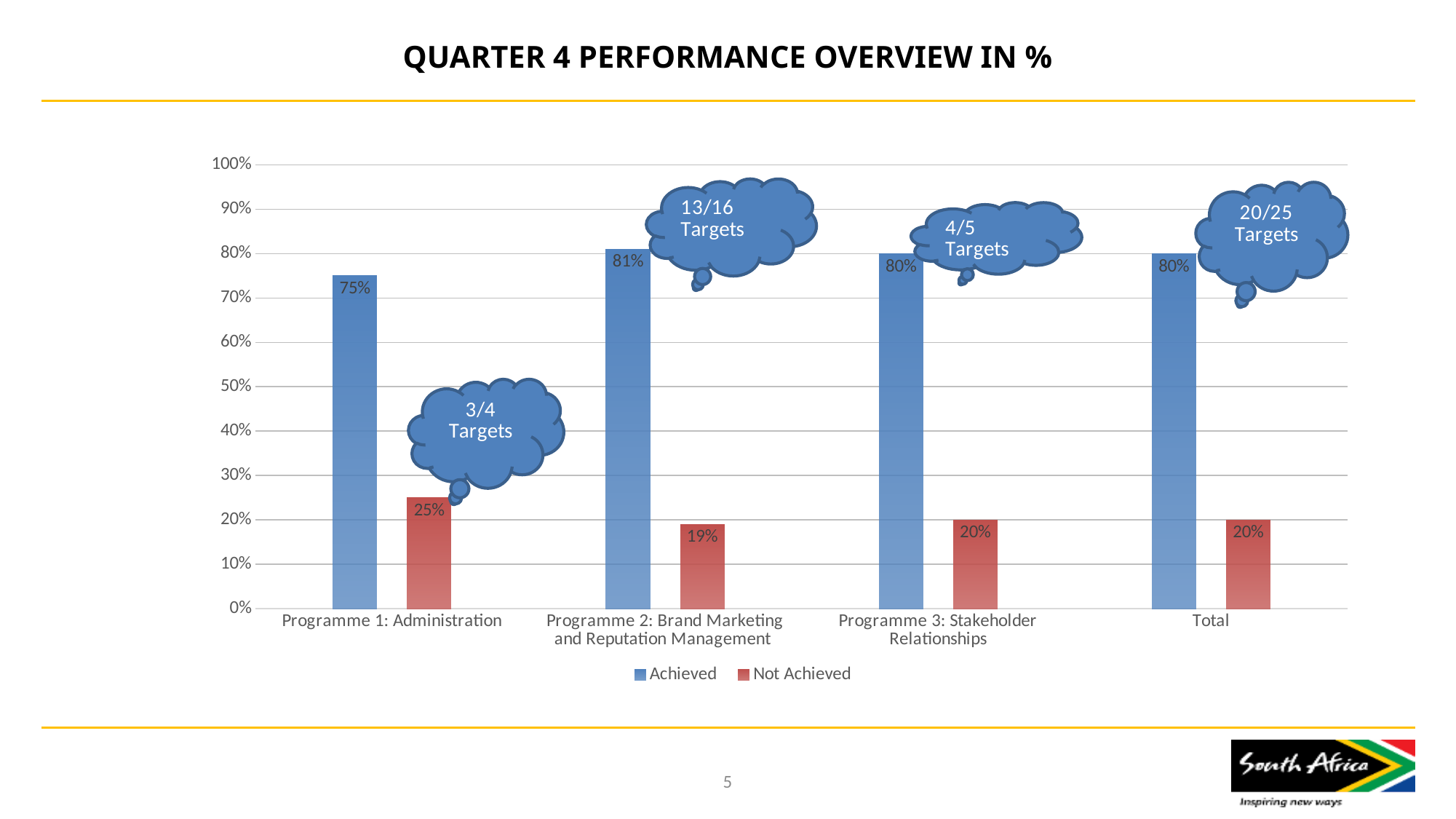
Which category has the highest Achieved value? Programme 2: Brand Marketing and Reputation Management How many series does the legend list? 2 What is the Achieved value for Programme 1: Administration? 75% How many categories are shown on the x axis? 4 What is the Achieved value for Total? 80% Which is larger, the Not Achieved value for Programme 1: Administration or for Programme 2: Brand Marketing and Reputation Management? Programme 1: Administration What is the Not Achieved value for Programme 2: Brand Marketing and Reputation Management? 19% What kind of chart is shown on the slide? Bar chart What is the difference between the Achieved and Not Achieved values for Programme 3: Stakeholder Relationships? 60% Is the Achieved value for Programme 2: Brand Marketing and Reputation Management greater or less than 70%? greater Which category has the lowest Achieved value? Programme 1: Administration What is the title of the chart? QUARTER 4 PERFORMANCE OVERVIEW IN %